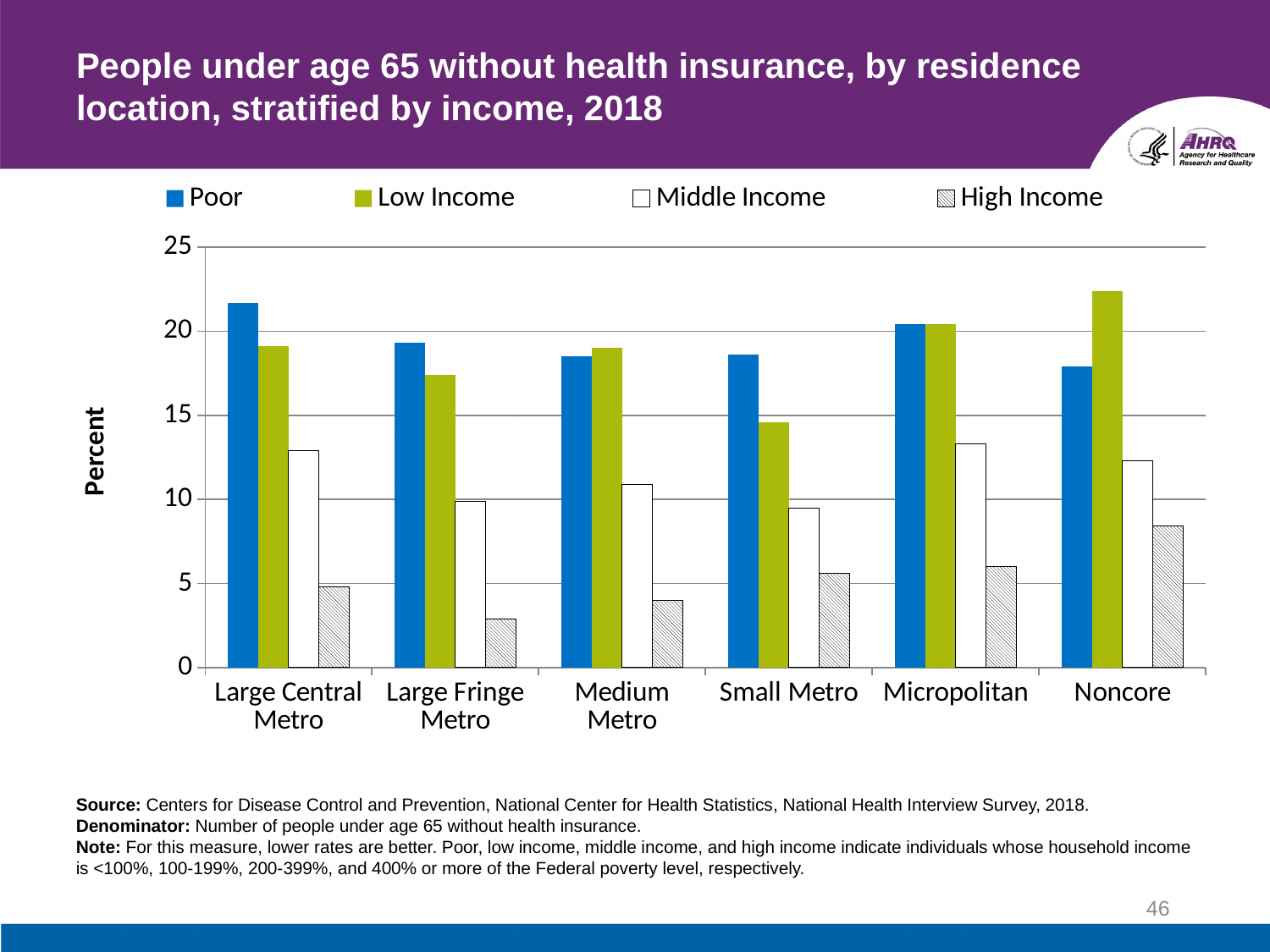
How many residence location categories are shown on the x axis? 6 Is the High Income value for Noncore greater or less than 10? less What is the label on the y axis? Percent Is the Poor value for Large Central Metro greater or less than 20? greater For Noncore, which is larger: the Poor value or the Low Income value? Low Income Is the Middle Income value for Micropolitan greater or less than 10? greater What kind of chart is shown on the slide? Bar chart Which residence location has the lowest Low Income value? Small Metro Which residence location has the lowest High Income value? Large Fringe Metro Which residence location has the highest Low Income value? Noncore How many series does the legend list? 4 Which residence location has the highest Poor value? Large Central Metro